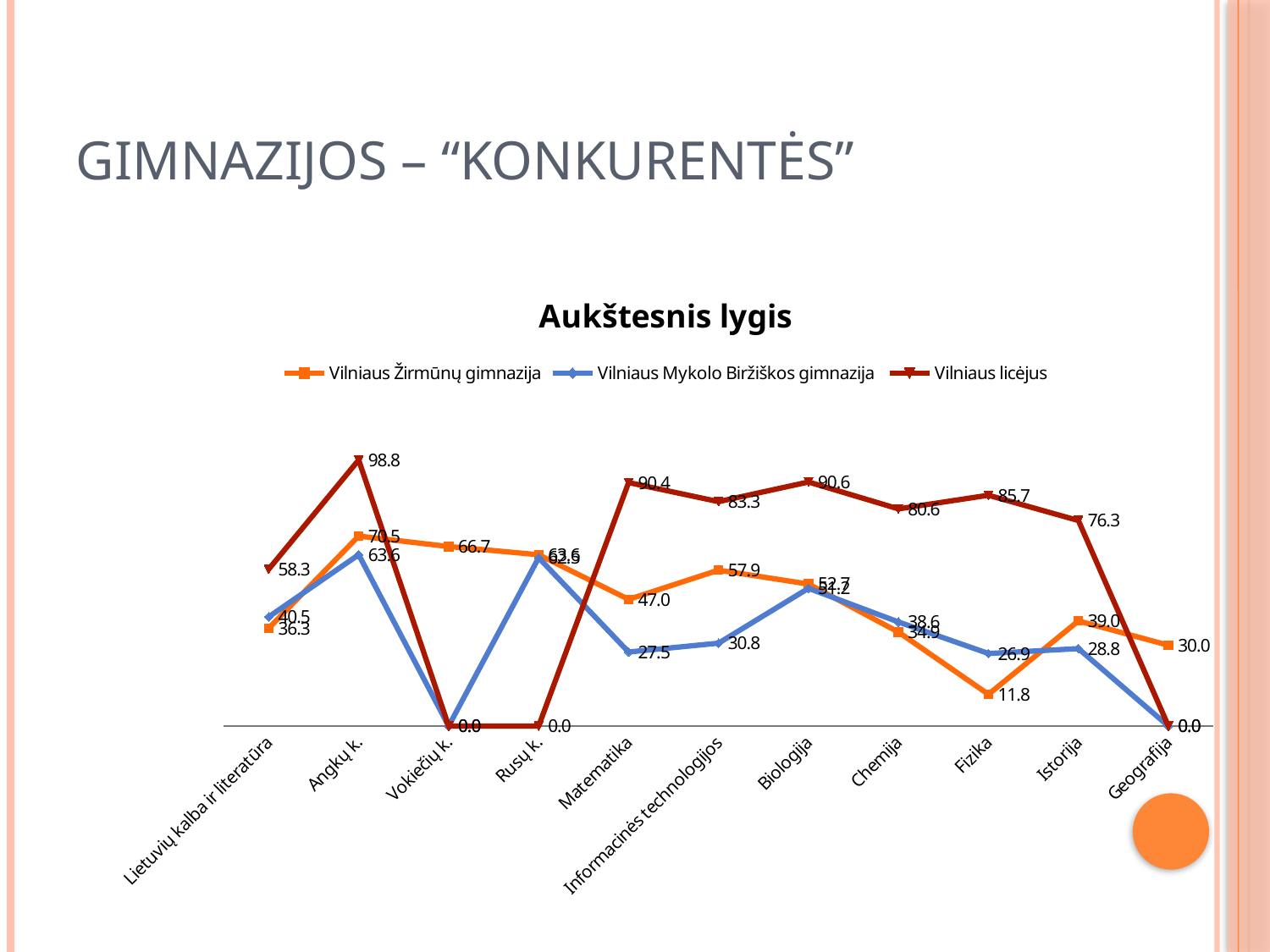
How many subject categories are shown on the x axis? 11 In Chemija, which has the larger value: Vilniaus Žirmūnų gimnazija or Vilniaus Mykolo Biržiškos gimnazija? Vilniaus Mykolo Biržiškos gimnazija What is the title of the chart? Aukštesnis lygis What is the value for Vilniaus licėjus in Istorija? 76.3 What type of chart is shown on the slide? line chart What is the value for Vilniaus Žirmūnų gimnazija in Fizika? 11.8 In which subject does Vilniaus licėjus have its highest value? Anglų k. What is the value for Vilniaus Mykolo Biržiškos gimnazija in Matematika? 27.5 How many series does the legend list? 3 In Matematika, how much higher is Vilniaus licėjus than Vilniaus Žirmūnų gimnazija? 43.4 What is the value for Vilniaus licėjus in Anglų k.? 98.8 In which subject does Vilniaus Žirmūnų gimnazija have its lowest value? Fizika